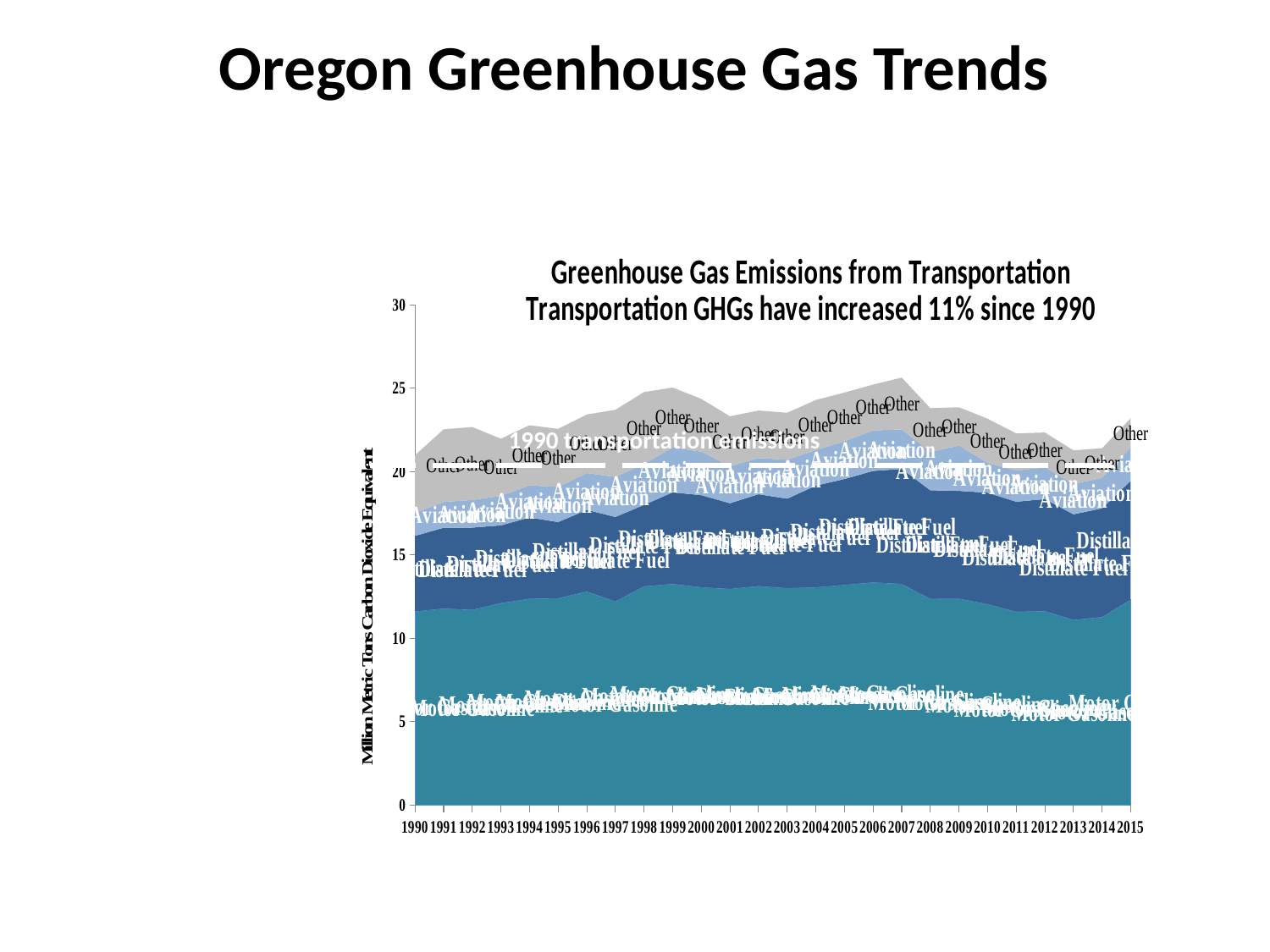
What kind of chart is shown on the slide? Stacked area chart Is the total transportation emissions value for 1990 greater or less than 20? greater What is the first year shown on the x axis? 1990 According to the chart's subtitle, by what percentage have transportation GHGs increased since 1990? 11% What is the title of the chart? Greenhouse Gas Emissions from Transportation Is the Motor Gasoline value for 1990 greater or less than 10? greater What is the last year shown on the x axis? 2015 Is the total transportation emissions value for 2007 greater or less than 20? greater Which series forms the bottom (largest) layer of the stacked area chart? Motor Gasoline How many years are shown along the x axis of the chart? 26 What is the unit shown on the y axis of the chart? Million Metric Tons Carbon Dioxide Equivalent